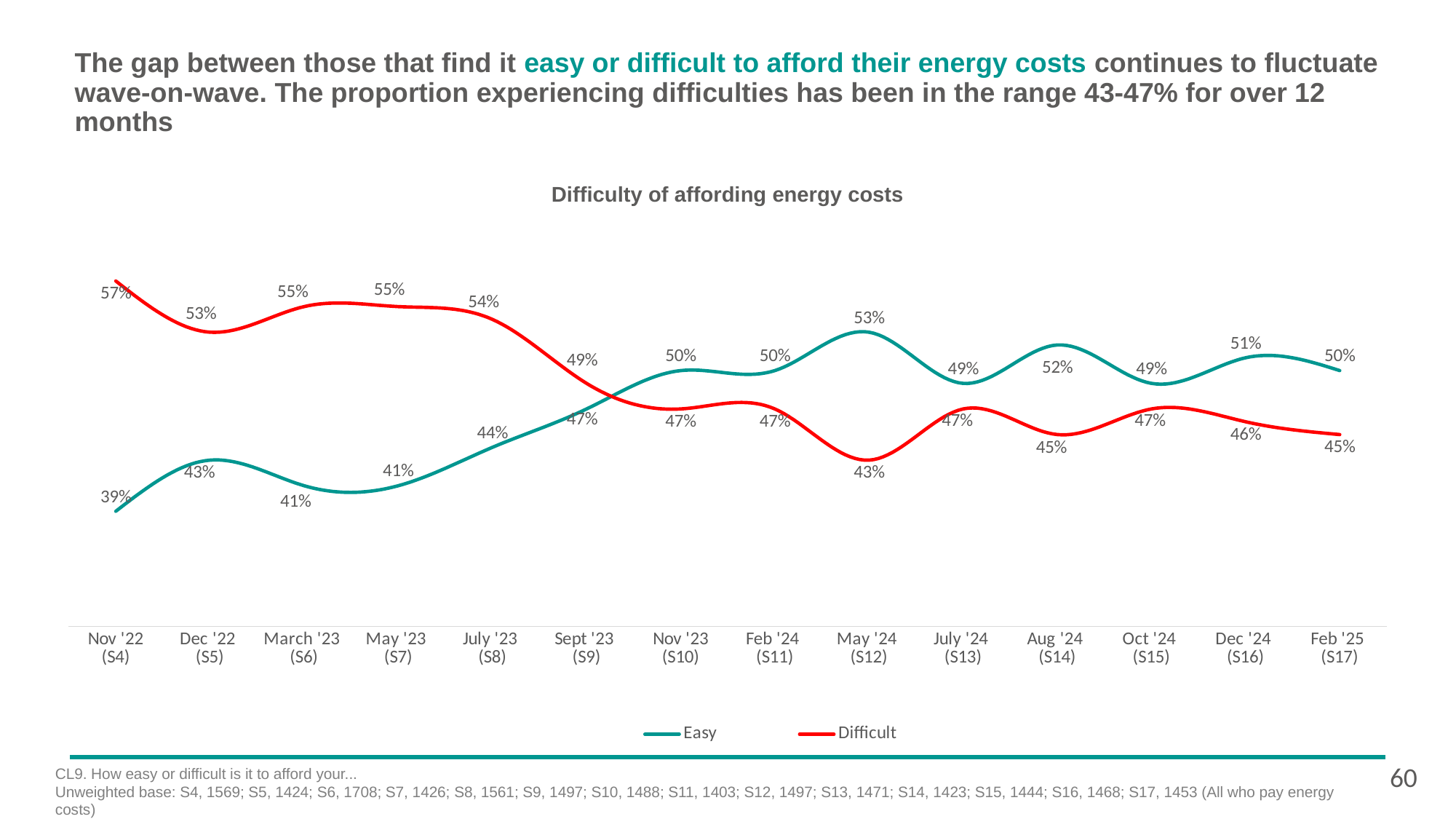
What is the value for Easy in Feb '25 (S17)? 50% How many waves (time points) are shown on the x axis? 14 In which wave does the Easy series reach its highest value? May '24 (S12) In Feb '25 (S17), which series has the higher value, Easy or Difficult? Easy What is the value for Easy in Nov '22 (S4)? 39% In which wave is the Difficult series at its lowest value? May '24 (S12) What is the title of the chart? Difficulty of affording energy costs What kind of chart is shown on the slide? Line chart What is the difference between the Difficult and Easy values in Nov '22 (S4)? 18 percentage points How many series does the legend list? 2 What is the value for Difficult in May '24 (S12)? 43% What is the value for Difficult in Nov '22 (S4)? 57%